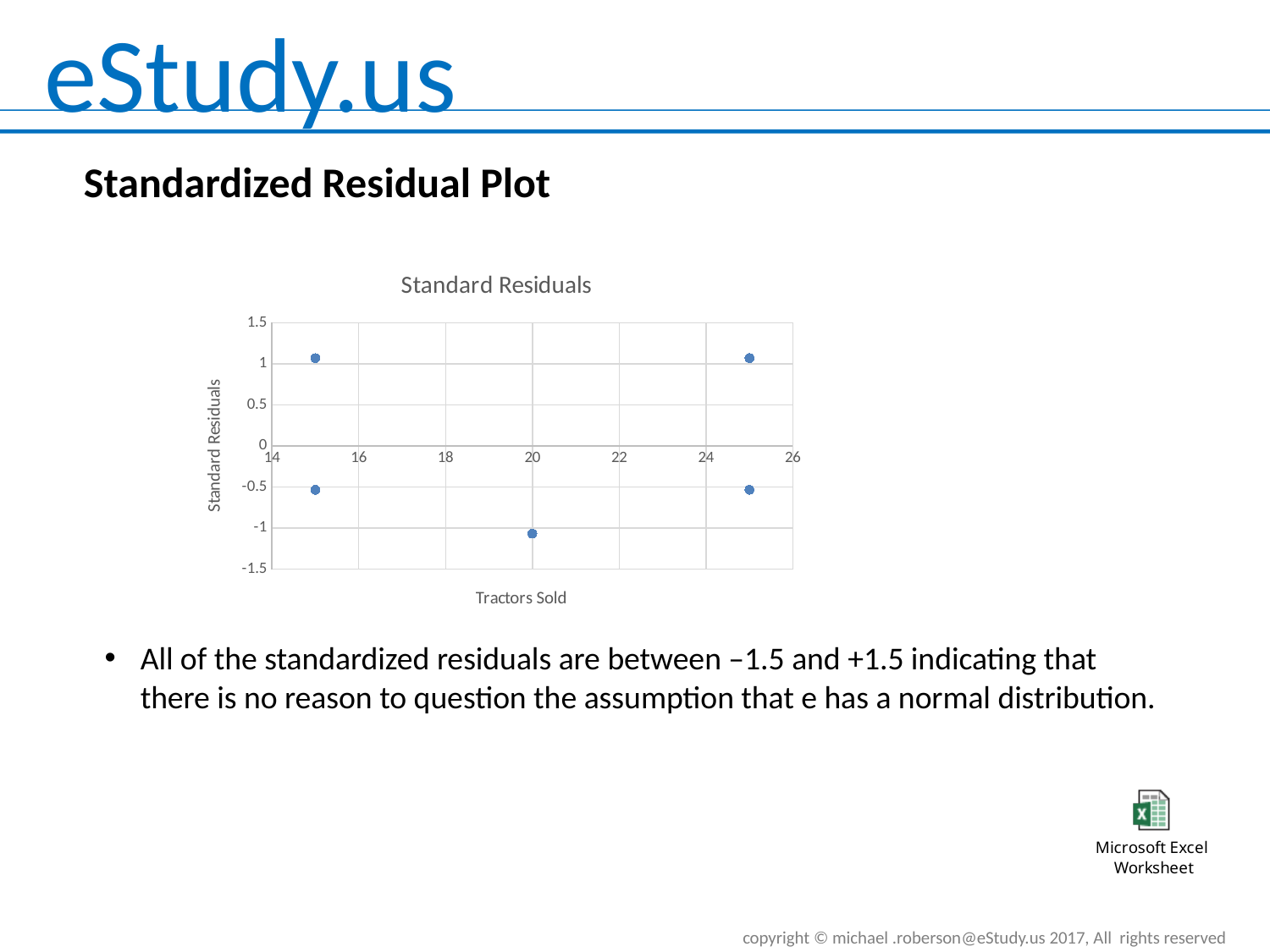
Is the standard residual for the upper point at 25 tractors sold greater or less than 0.5? greater How many points are plotted at 15 tractors sold? 2 How many points have a negative standard residual? 3 How many points are plotted at 20 tractors sold? 1 Is the standard residual for the lower point at 15 tractors sold greater or less than 0? less What is the title of the chart? Standard Residuals What is the label of the x axis of the chart? Tractors Sold What kind of chart is shown on the slide? Scatter plot At which value of Tractors Sold is the lowest standard residual plotted? 20 Is the standard residual for the point at 20 tractors sold greater or less than -0.5? less